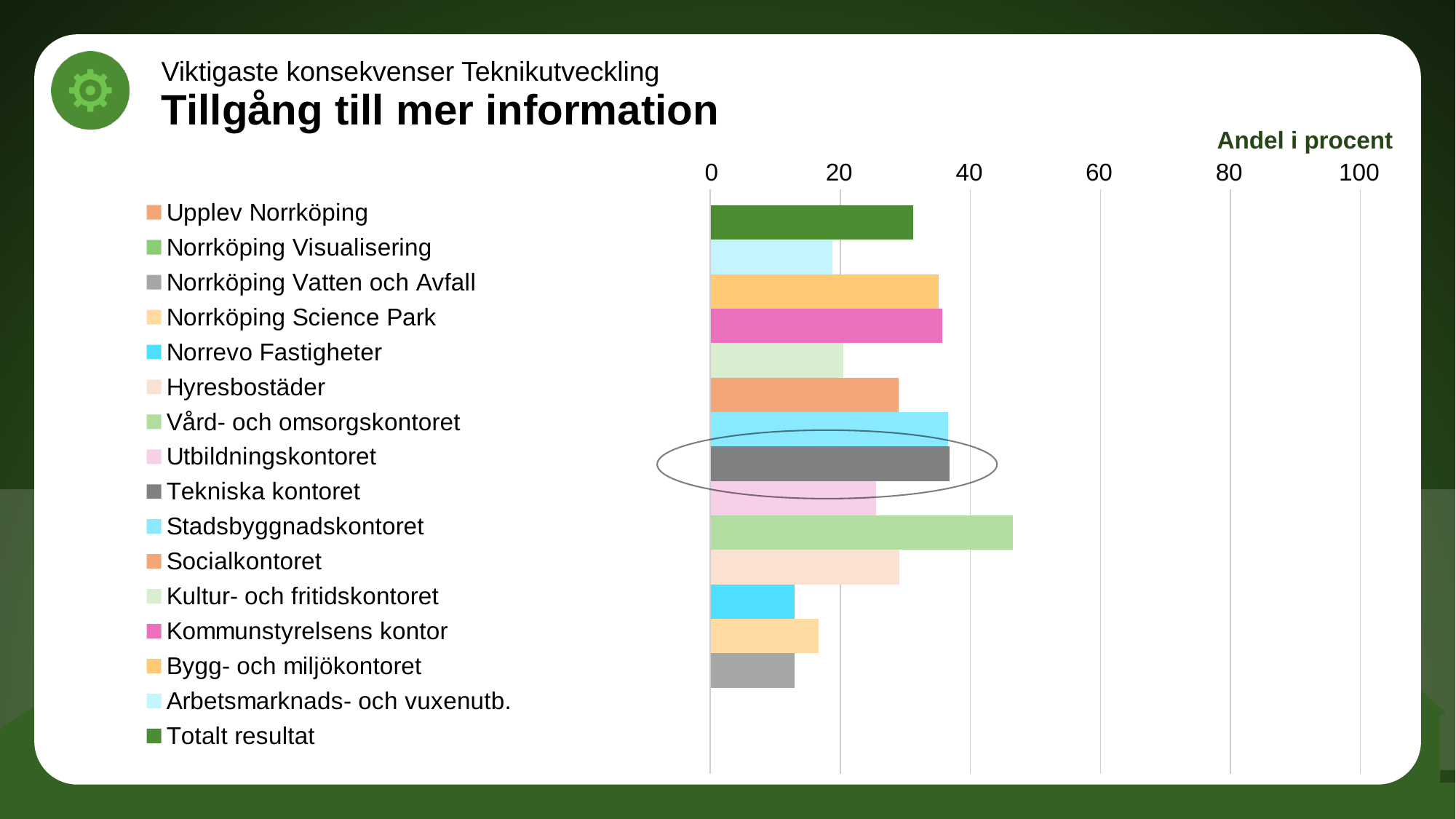
What kind of chart is shown on the slide? bar chart Which is larger, the value for Vård- och omsorgskontoret or the value for Totalt resultat? Vård- och omsorgskontoret Which category has the highest value in the chart? Vård- och omsorgskontoret What is the label shown above the horizontal axis of the chart? Andel i procent Which is larger, the value for Kommunstyrelsens kontor or the value for Norrevo Fastigheter? Kommunstyrelsens kontor Is the value for Socialkontoret greater or less than 20? greater How many entries does the chart legend list? 16 Is the value for Totalt resultat greater or less than 20? greater Which category's bar is circled in the chart? Tekniska kontoret Is the value for Vård- och omsorgskontoret greater or less than 40? greater